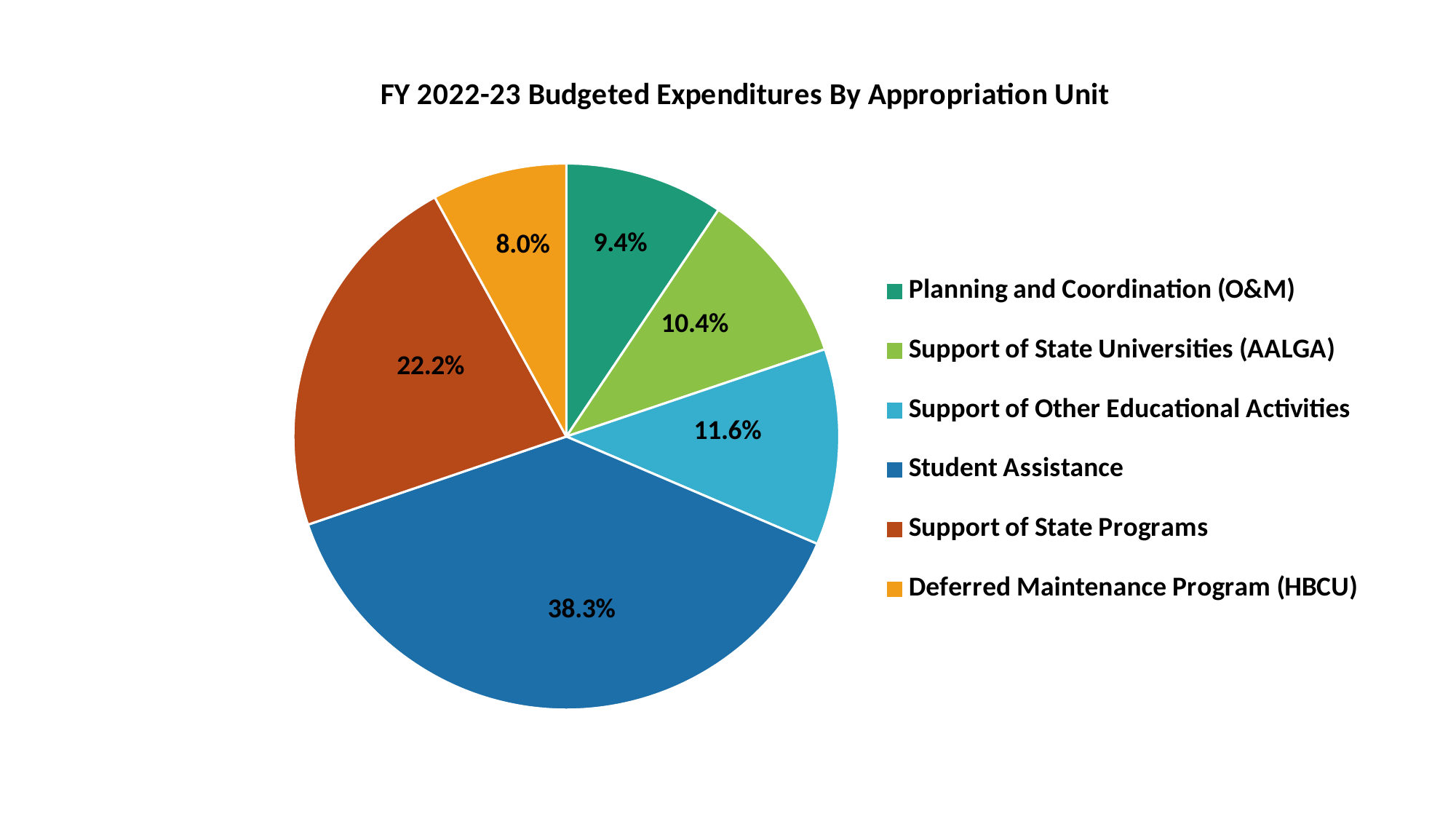
What is the title of the chart? FY 2022-23 Budgeted Expenditures By Appropriation Unit What share of budgeted expenditures goes to Deferred Maintenance Program (HBCU)? 8.0% Which has a larger share, Support of State Universities (AALGA) or Support of Other Educational Activities? Support of Other Educational Activities What share of budgeted expenditures goes to Planning and Coordination (O&M)? 9.4% How many appropriation units are shown in the pie chart? 6 What is the difference in percentage points between Student Assistance and Support of State Programs? 16.1 Which appropriation unit has the largest share of budgeted expenditures? Student Assistance Which appropriation unit has the smallest share of budgeted expenditures? Deferred Maintenance Program (HBCU) What share of budgeted expenditures goes to Support of Other Educational Activities? 11.6% What type of chart is shown on the slide? Pie chart What share of budgeted expenditures goes to Student Assistance? 38.3%